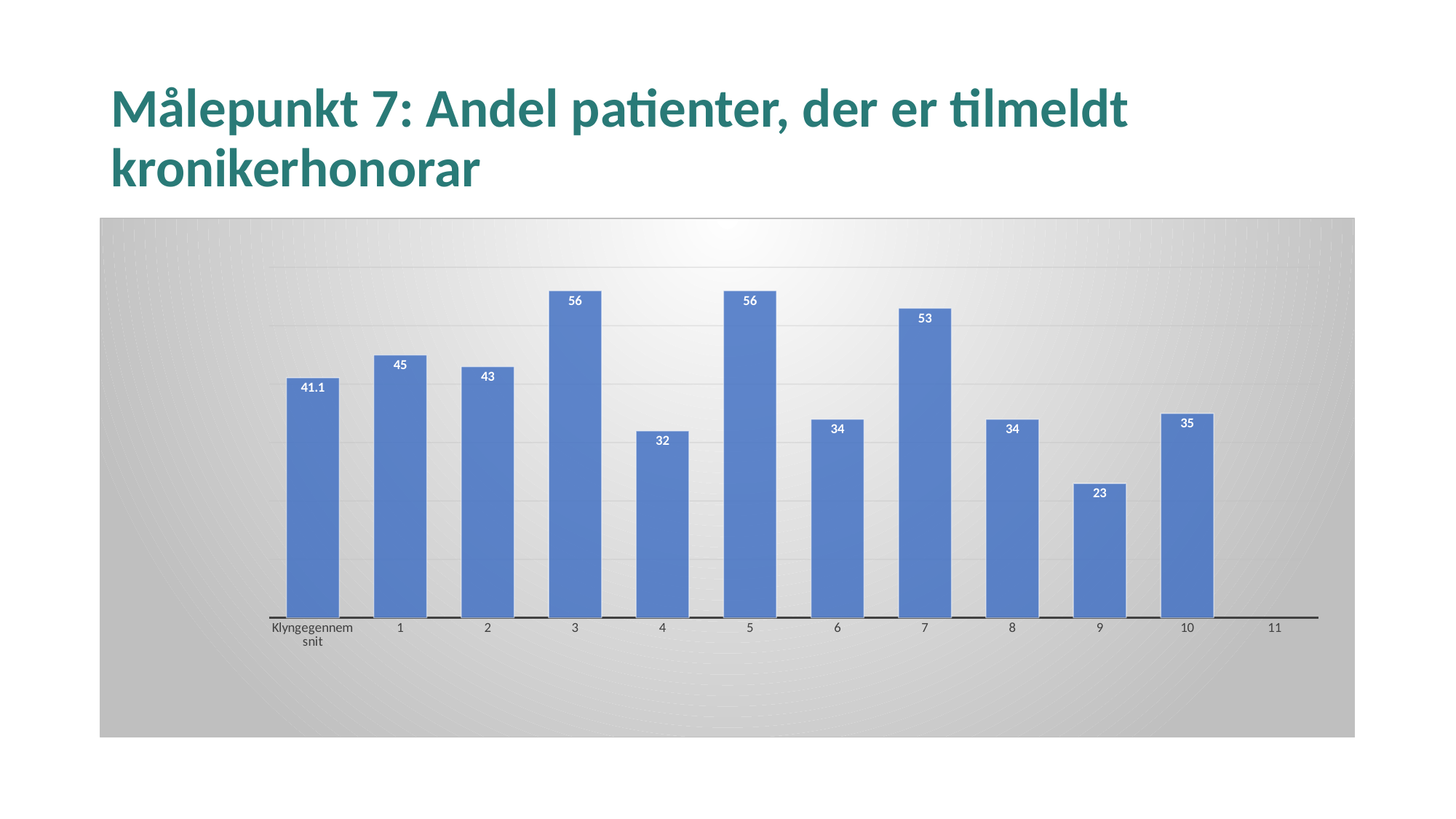
What is the value for category 7? 53 Which is larger, the value for category 7 or the value for category 8? category 7 What kind of chart is shown on the slide? bar chart What is the value for category 10? 35 What is the difference between the values for category 1 and category 2? 2 Among the bars shown, which category has the lowest value? 9 How many category labels are shown on the x axis? 12 What is the difference between the values for category 3 and category 4? 24 What is the value for category 9? 23 What is the value for Klyngegennemsnit? 41.1 What is the value for category 3? 56 What is the title of the slide? Målepunkt 7: Andel patienter, der er tilmeldt kronikerhonorar